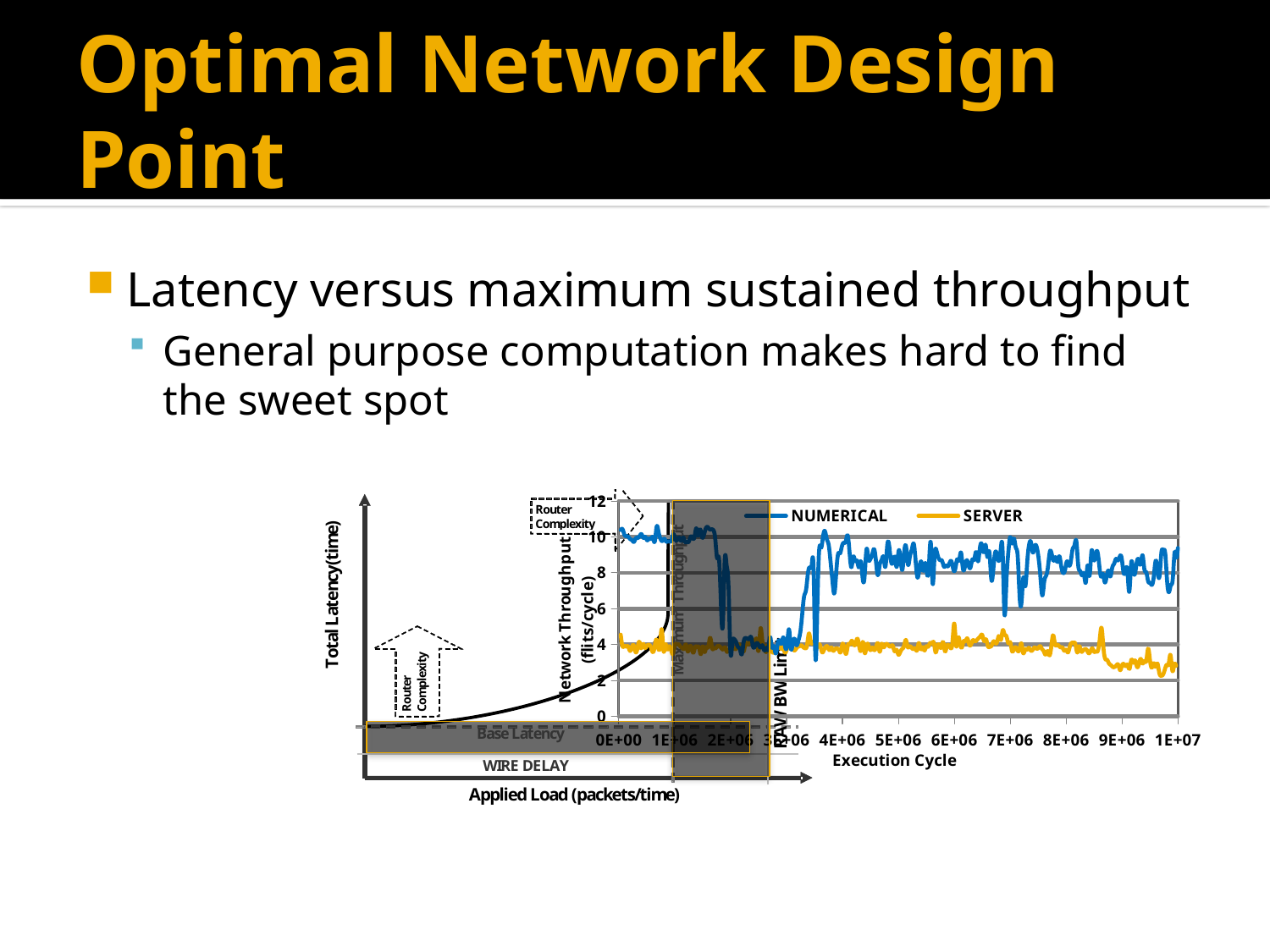
What kind of chart is the Network Throughput versus Execution Cycle chart? line chart In the Network Throughput chart, which series has the higher value at an execution cycle of 8E+06, NUMERICAL or SERVER? NUMERICAL In the Network Throughput chart, which series has the higher value at an execution cycle of 6E+06, NUMERICAL or SERVER? NUMERICAL What is the last tick value shown on the Execution Cycle axis of the Network Throughput chart? 1E+07 What is the label of the vertical axis of the Network Throughput chart? Network Throughput (flits/cycle) In the Network Throughput chart, does the SERVER series rise or fall between execution cycles 8E+06 and 1E+07? fall In the Network Throughput chart, is the NUMERICAL value at an execution cycle of 5E+06 greater or less than 6? greater In the Network Throughput chart, is the SERVER value at an execution cycle of 9.5E+06 greater or less than 4? less What are the two series named in the legend of the Network Throughput chart? NUMERICAL and SERVER In the Network Throughput chart, is the SERVER value at an execution cycle of 5E+06 greater or less than 6? less What is the highest tick value shown on the vertical axis of the Network Throughput chart? 12 How many series does the legend of the Network Throughput chart list? 2